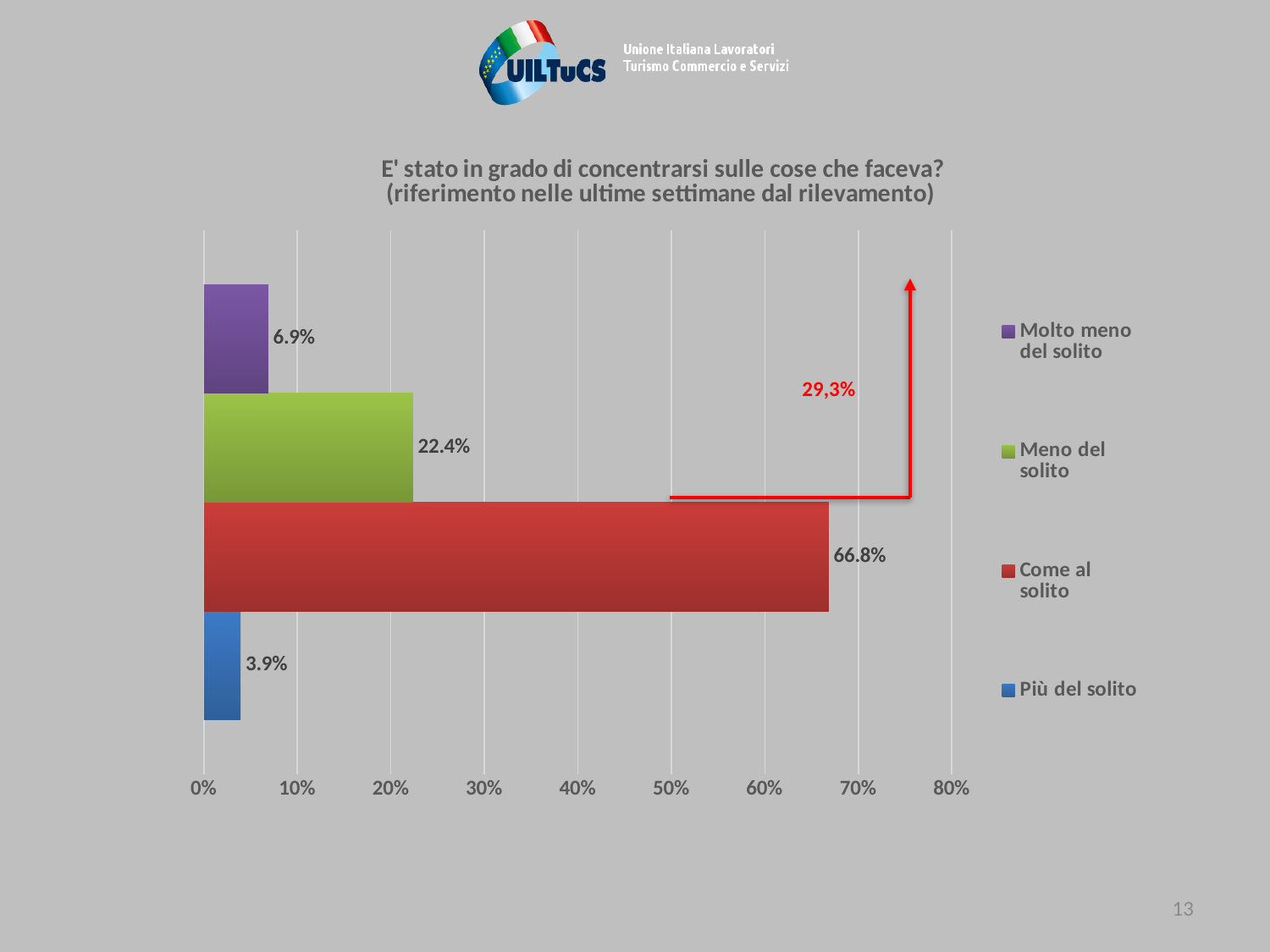
Which category has the lowest value? Più del solito What is the difference between the values for "Come al solito" and "Meno del solito"? 44.4% What is the value for "Più del solito"? 3.9% What value is written in red next to the arrow annotation on the chart? 29,3% What kind of chart is shown on the slide? bar chart Which is larger, the value for "Molto meno del solito" or the value for "Più del solito"? Molto meno del solito Which category has the highest value? Come al solito What is the value for "Molto meno del solito"? 6.9% Is the value for "Come al solito" greater or less than 60%? greater What is the value for "Meno del solito"? 22.4% How many categories does the legend list? 4 What is the value for "Come al solito"? 66.8%